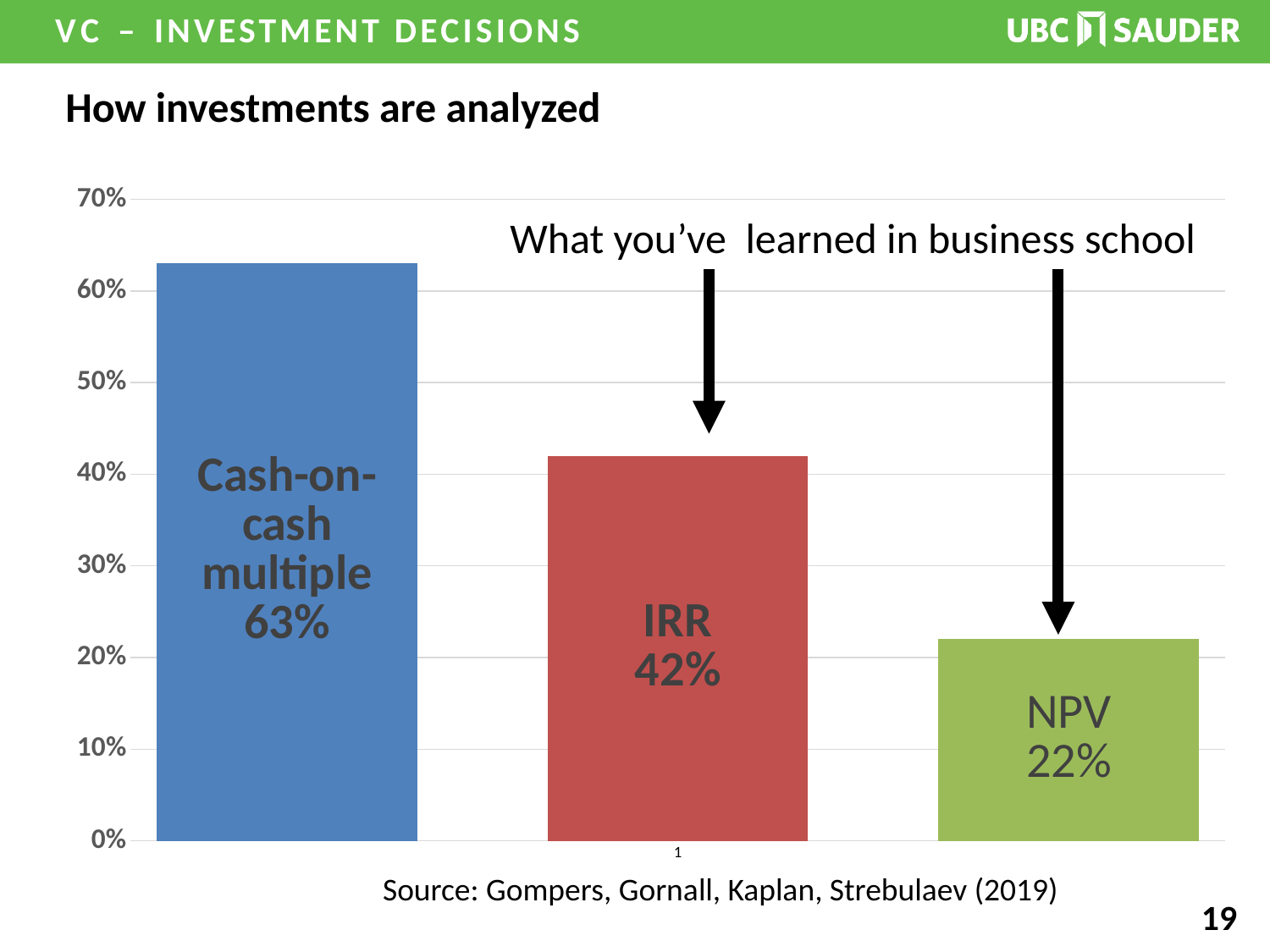
What is the value for NPV? 22% What is the title of the chart on the slide? How investments are analyzed Is the value for IRR greater or less than 50%? less What is the value for IRR? 42% What kind of chart is shown on the slide? Bar chart How many categories are shown in the chart? 3 Which category has the lowest value? NPV What is the difference between the IRR value and the NPV value? 20% What is the value for Cash-on-cash multiple? 63% Which is larger, the value for IRR or the value for NPV? IRR What is the difference between the Cash-on-cash multiple value and the IRR value? 21% Which category has the highest value? Cash-on-cash multiple